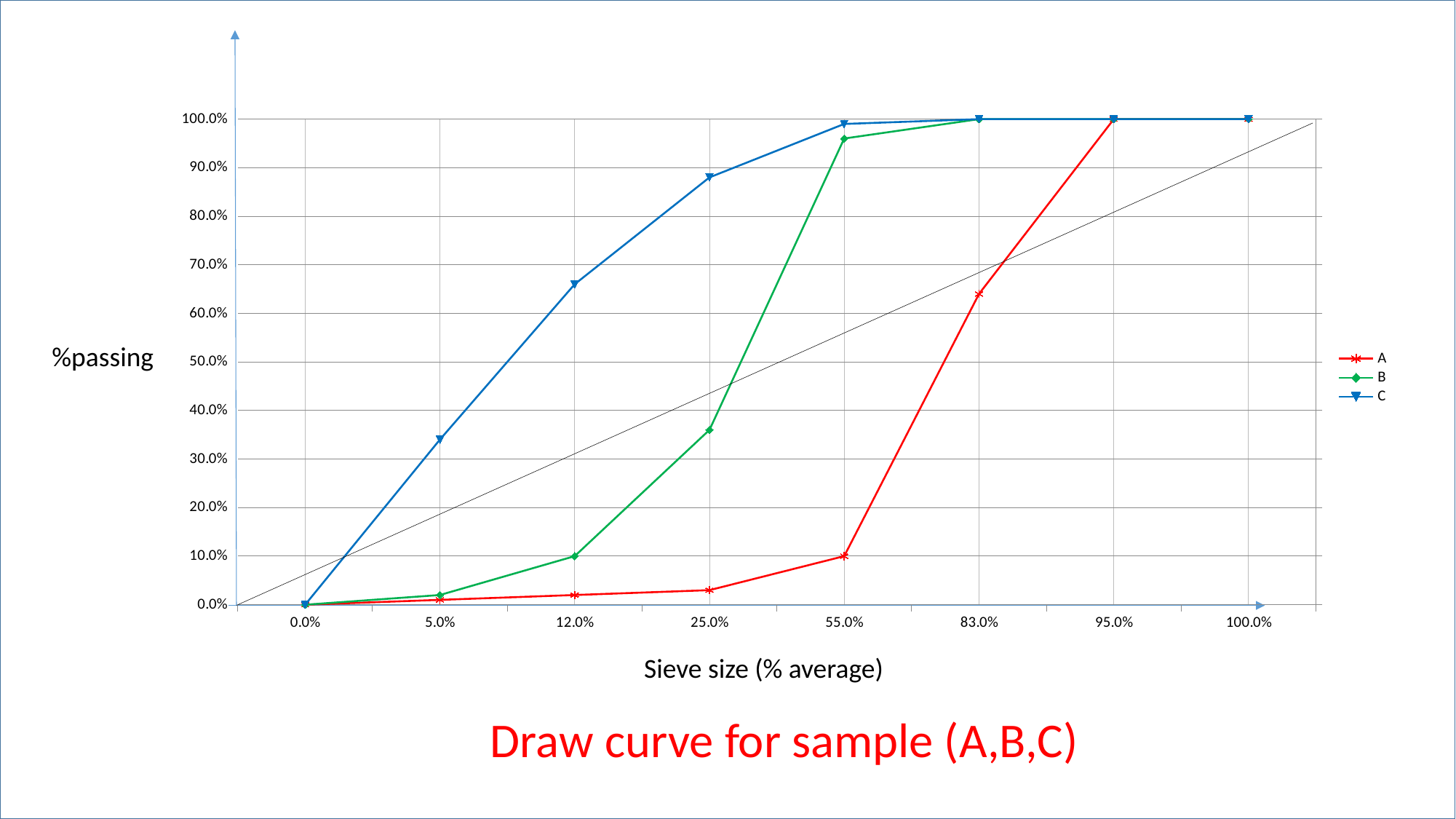
How many series does the legend list? 3 How many sieve size categories are shown on the x axis? 8 Do the values of series C rise or fall as sieve size increases along the x axis? rise What is the label on the x axis? Sieve size (% average) Is the value for series A at sieve size 83.0% greater or less than 70.0%? less What is the value of series B at sieve size 12.0%? 10.0% What is the value of series A at sieve size 95.0%? 100.0% What kind of chart is shown on the slide? line chart Is the value for series C at sieve size 12.0% greater or less than 60.0%? greater Is the value for series B at sieve size 25.0% greater or less than 30.0%? greater At sieve size 25.0%, which series has the larger value, B or C? C What is the value of series A at sieve size 55.0%? 10.0%